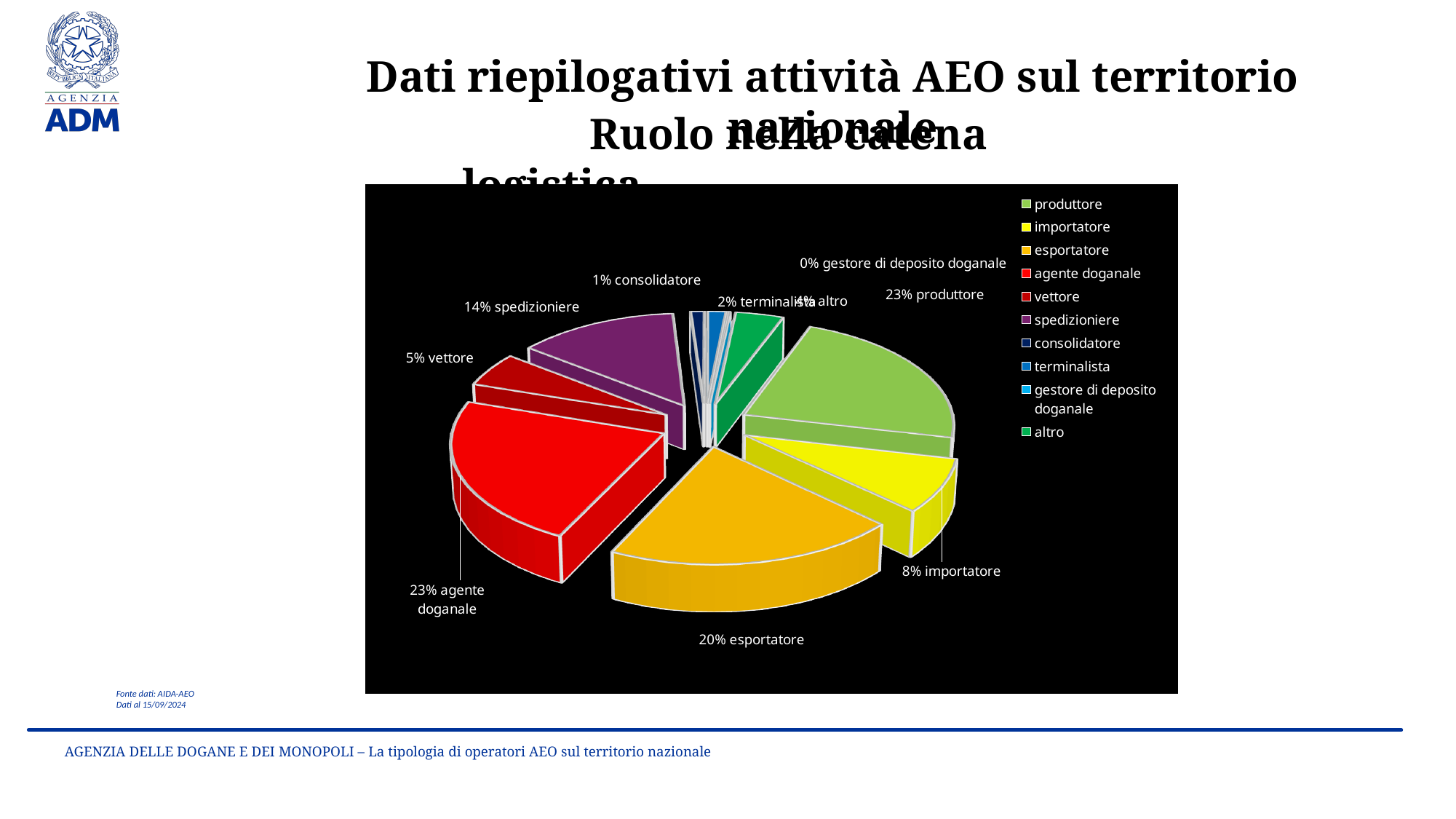
What percentage is shown for vettore? 5% What percentage of the pie is labelled for esportatore? 20% How many entries does the legend list? 10 How many categories does the pie chart show? 10 What kind of chart is shown on the slide? pie chart Which is larger, the share for esportatore or the share for spedizioniere? esportatore What colour represents produttore in the legend? green Which category has the smallest share of the pie? gestore di deposito doganale What is the value shown for importatore? 8% What percentage is shown for consolidatore? 1% What is the difference in percentage points between produttore and importatore? 15 What share of the pie does spedizioniere hold? 14%